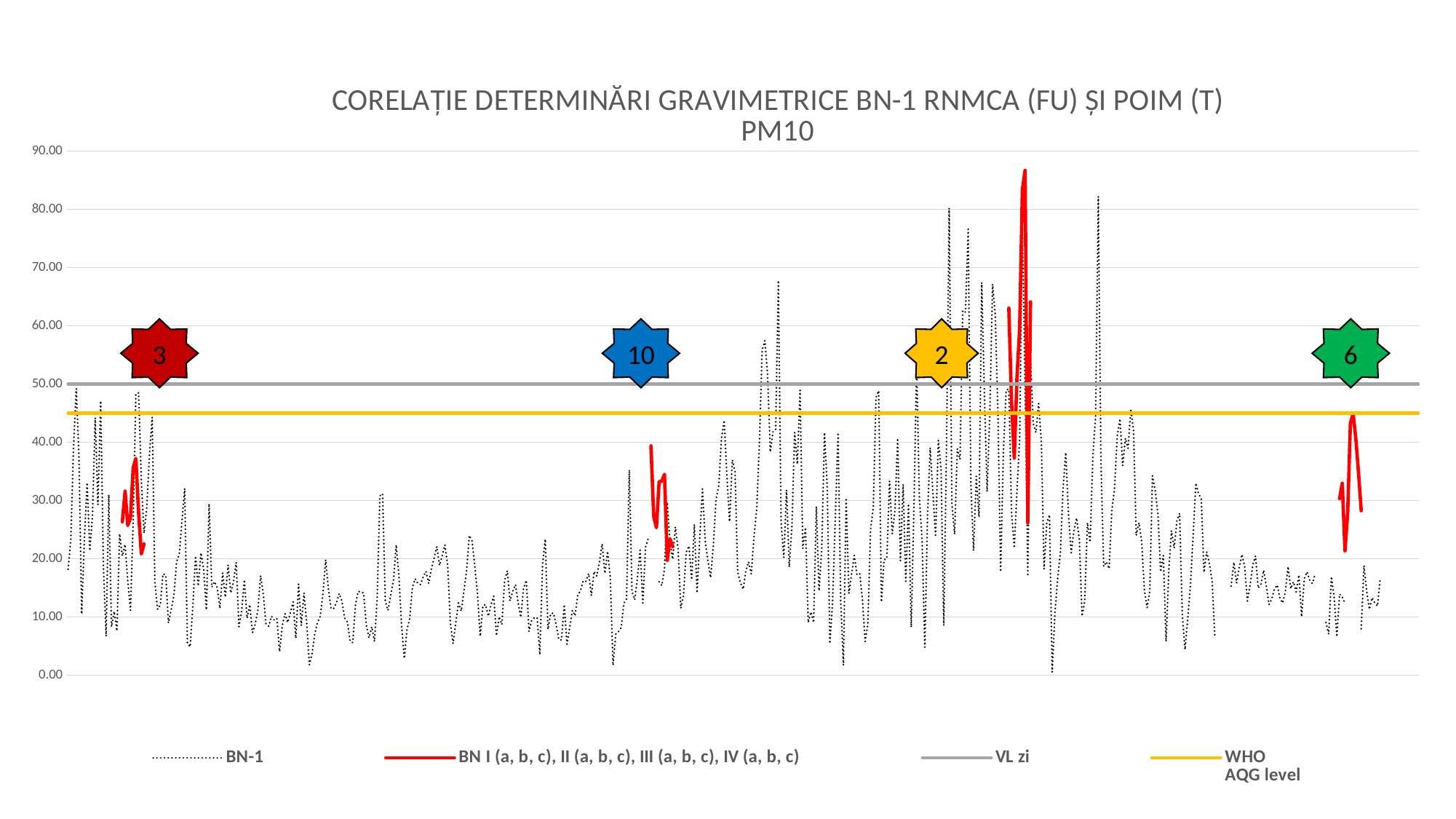
At what value does the VL zi line sit on the y axis? 50.00 What is the maximum value shown on the y axis? 90.00 Is the highest peak of the BN-1 series greater or less than 70? greater Is the WHO AQG level line greater or less than 50? less Is the lowest point of the BN-1 series greater or less than 10? less What kind of chart is shown on the slide? line chart What is the title of the chart? CORELAȚIE DETERMINĂRI GRAVIMETRICE BN-1 RNMCA (FU) ȘI POIM (T) PM10 Which horizontal reference line is higher, VL zi or WHO AQG level? VL zi How many series does the legend list? 4